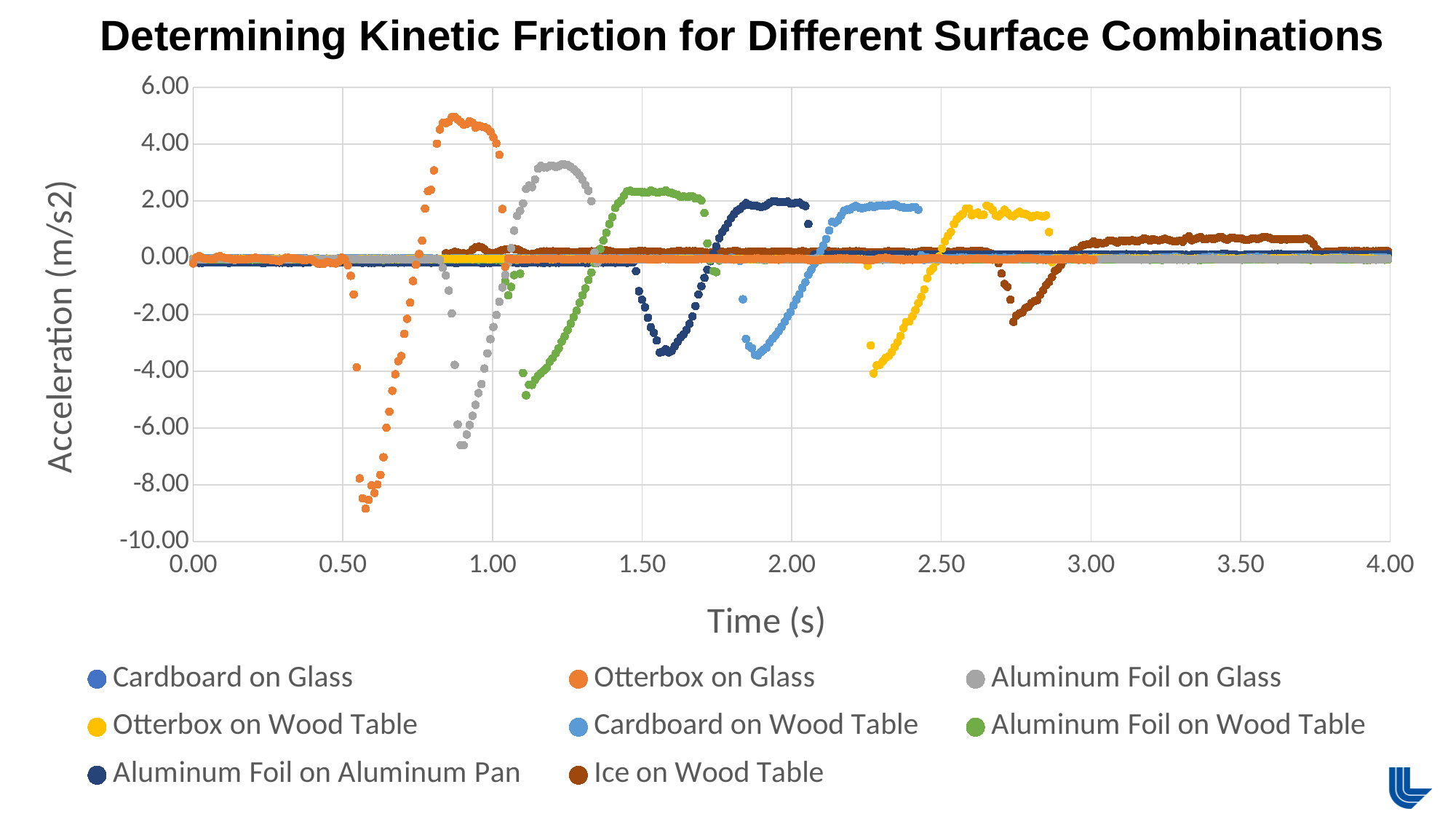
Which series reaches the lowest acceleration value on the chart? Otterbox on Glass Is the plateau acceleration for Ice on Wood Table greater or less than 2.00? less Is the lowest acceleration for Otterbox on Glass greater or less than -8.00? less Is the lowest acceleration for Aluminum Foil on Glass greater or less than -6.00? less Which series has a higher plateau acceleration, Aluminum Foil on Wood Table or Ice on Wood Table? Aluminum Foil on Wood Table What is the title of the chart? Determining Kinetic Friction for Different Surface Combinations Which series reaches the highest acceleration value on the chart? Otterbox on Glass What is the label of the vertical axis? Acceleration (m/s2) Which series has a higher peak acceleration, Otterbox on Glass or Aluminum Foil on Glass? Otterbox on Glass How many series does the legend list? 8 What kind of chart is shown on the slide? Scatter chart